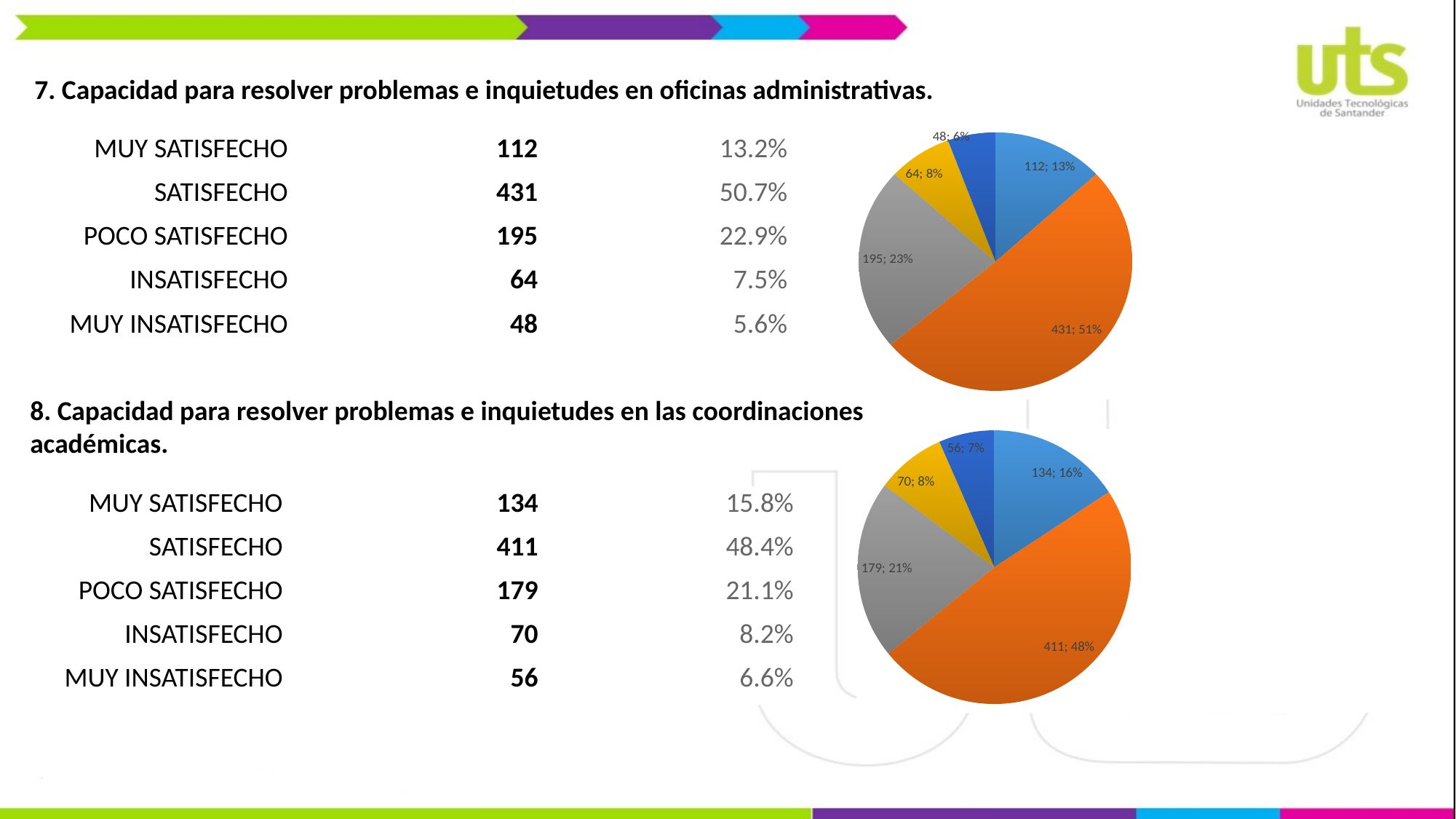
In the bottom pie chart (item 8), which is larger, the MUY SATISFECHO slice or the POCO SATISFECHO slice? POCO SATISFECHO In the bottom pie chart (item 8), what value is shown for the MUY SATISFECHO slice? 134 How many slices does the top pie chart (item 7) have? 5 In the top pie chart (item 7), what value is shown for the SATISFECHO slice? 431 What type of chart is used for item 7 (top chart)? pie chart In the bottom pie chart (item 8), what percentage share is shown for the INSATISFECHO slice? 8% In the top pie chart (item 7), what percentage share is shown for the POCO SATISFECHO slice? 23% In the top pie chart (item 7), what is the difference between the SATISFECHO value and the POCO SATISFECHO value? 236 In the top pie chart (item 7), which category has the smallest slice? MUY INSATISFECHO In the top pie chart (item 7), which category has the largest slice? SATISFECHO In the bottom pie chart (item 8), which category has the smallest slice? MUY INSATISFECHO In the bottom pie chart (item 8), what colour is the SATISFECHO slice? orange